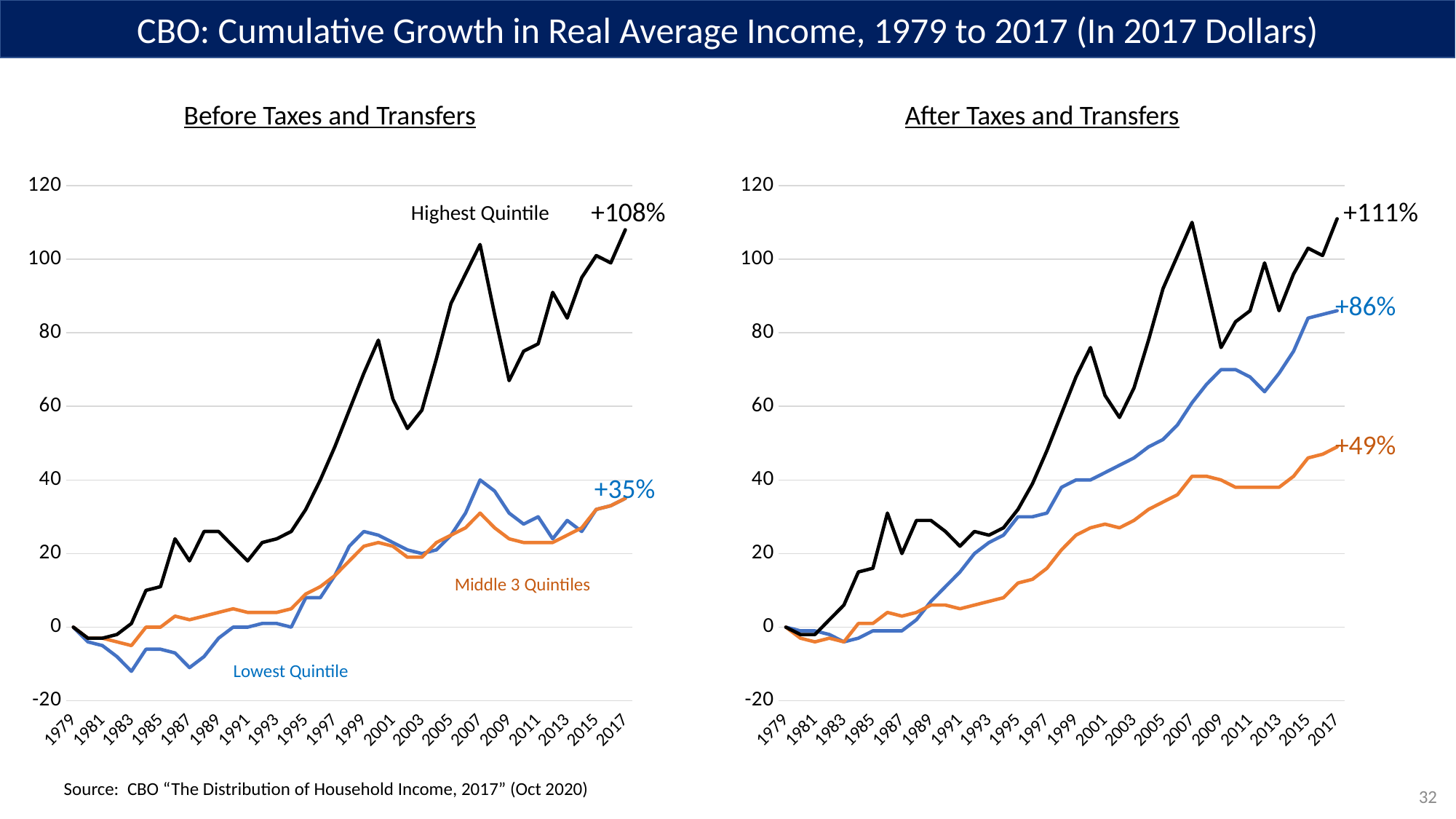
What is the difference in percentage points between the Highest Quintile's 2017 growth after taxes and transfers (+111%) and before taxes and transfers (+108%)? 3 percentage points In the 'Before Taxes and Transfers' chart, is the Highest Quintile's value in 2007 greater or less than 100? greater In the 'Before Taxes and Transfers' chart, is the Lowest Quintile's value in 1983 greater or less than 0? less In the 'After Taxes and Transfers' chart, which quintile group has the highest cumulative growth in 2017? Highest Quintile In the 'Before Taxes and Transfers' chart, what is the cumulative growth shown for the Lowest Quintile in 2017? +35% What kind of chart is the 'Before Taxes and Transfers' chart? Line chart In the 'Before Taxes and Transfers' chart, what is the cumulative growth shown for the Highest Quintile in 2017? +108% In the 'After Taxes and Transfers' chart, what is the cumulative growth shown for the Lowest Quintile in 2017? +86% How many quintile groups (lines) are plotted in the 'After Taxes and Transfers' chart? 3 In the 'After Taxes and Transfers' chart, what is the cumulative growth shown for the Middle 3 Quintiles in 2017? +49% In the 'After Taxes and Transfers' chart, what is the cumulative growth shown for the Highest Quintile in 2017? +111% In the 'After Taxes and Transfers' chart, which quintile group has the lowest cumulative growth in 2017? Middle 3 Quintiles